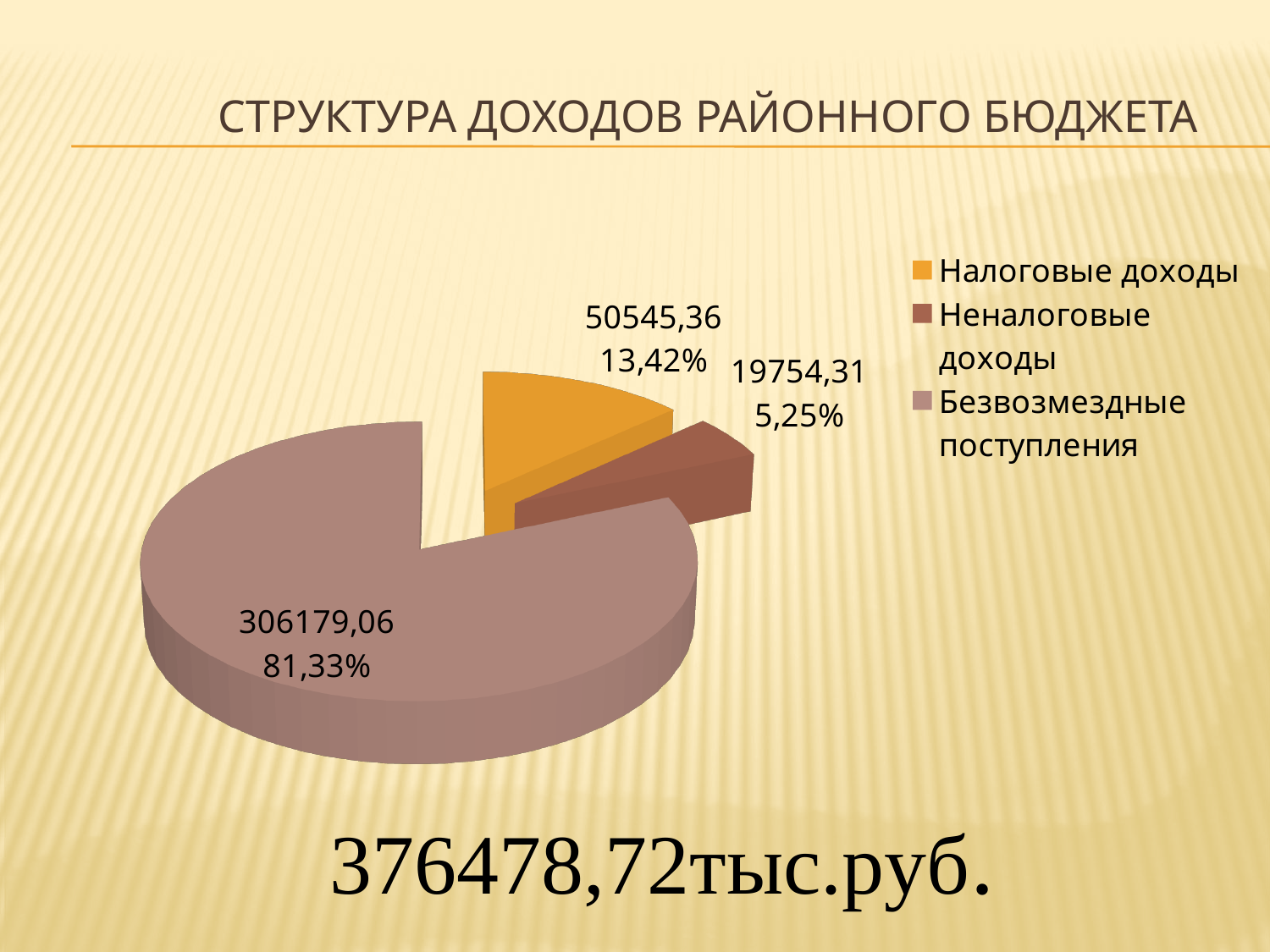
What is the value for Неналоговые доходы? 19754,31 What share of the pie does Неналоговые доходы take? 5,25% What kind of chart is shown on the slide? pie chart What is the difference between the values for Налоговые доходы and Неналоговые доходы? 30791,05 Which category has the smallest slice? Неналоговые доходы Which is larger, Налоговые доходы or Неналоговые доходы? Налоговые доходы Which category has the largest slice? Безвозмездные поступления How many categories does the legend list? 3 What share of the pie does Налоговые доходы take? 13,42% What share of the pie does Безвозмездные поступления take? 81,33% What is the value for Безвозмездные поступления? 306179,06 What is the value for Налоговые доходы? 50545,36